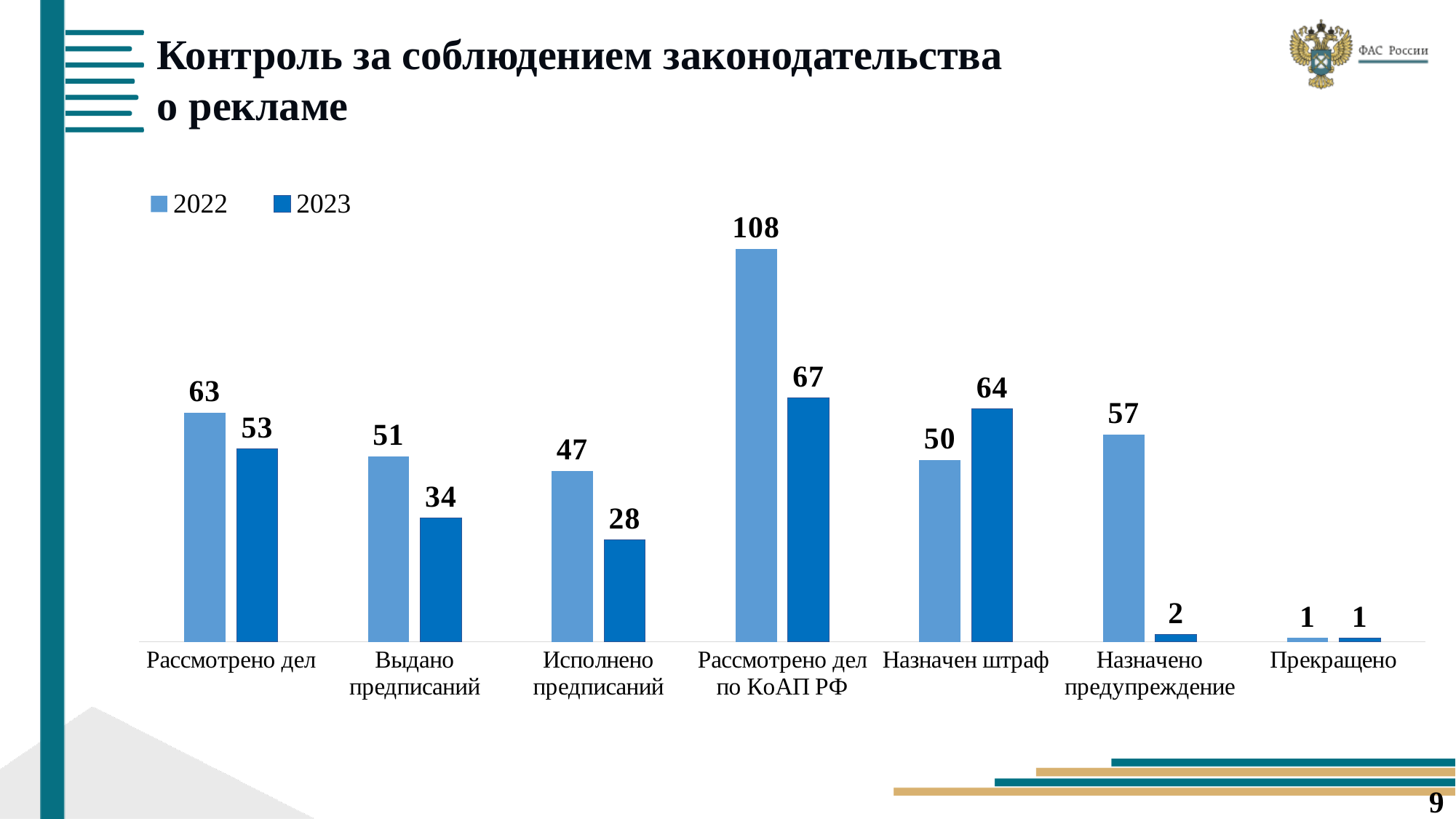
What is the difference between the 2022 and 2023 values for 'Рассмотрено дел по КоАП РФ'? 41 How many series does the legend list? 2 What is the 2022 value for 'Рассмотрено дел по КоАП РФ'? 108 What kind of chart is shown on the slide? bar chart What are the two series listed in the legend? 2022 and 2023 How many categories are shown on the x axis? 7 What is the 2023 value for 'Выдано предписаний'? 34 What is the 2023 value for 'Назначено предупреждение'? 2 Which is larger for 'Назначен штраф': the 2022 value or the 2023 value? 2023 Which category has the highest 2022 value? Рассмотрено дел по КоАП РФ Which category has the lowest 2023 value? Прекращено What is the difference between the 2022 and 2023 values for 'Исполнено предписаний'? 19